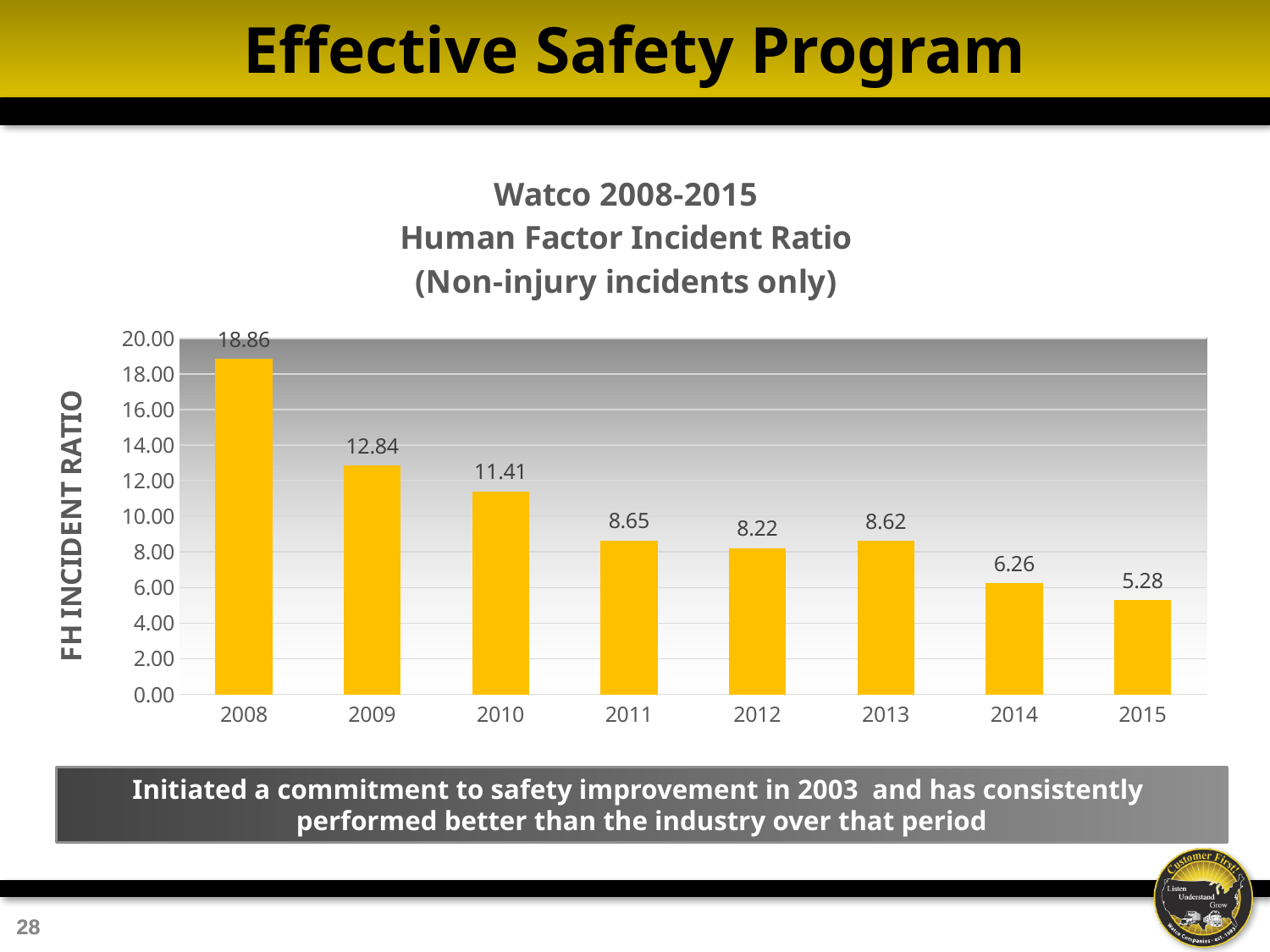
What is the difference between the FH incident ratio in 2009 and in 2010? 1.43 What is the label of the vertical axis of the chart? FH INCIDENT RATIO What is the FH incident ratio for 2015? 5.28 Which year has a higher FH incident ratio, 2011 or 2014? 2011 Which year has the lowest FH incident ratio? 2015 Which year has the highest FH incident ratio? 2008 What is the FH incident ratio for 2012? 8.22 Is the FH incident ratio for 2010 greater or less than 10.00? greater How many years are shown on the x axis of the chart? 8 What kind of chart is shown on the slide? bar chart What is the FH incident ratio for 2008? 18.86 What is the difference between the FH incident ratio in 2008 and in 2015? 13.58